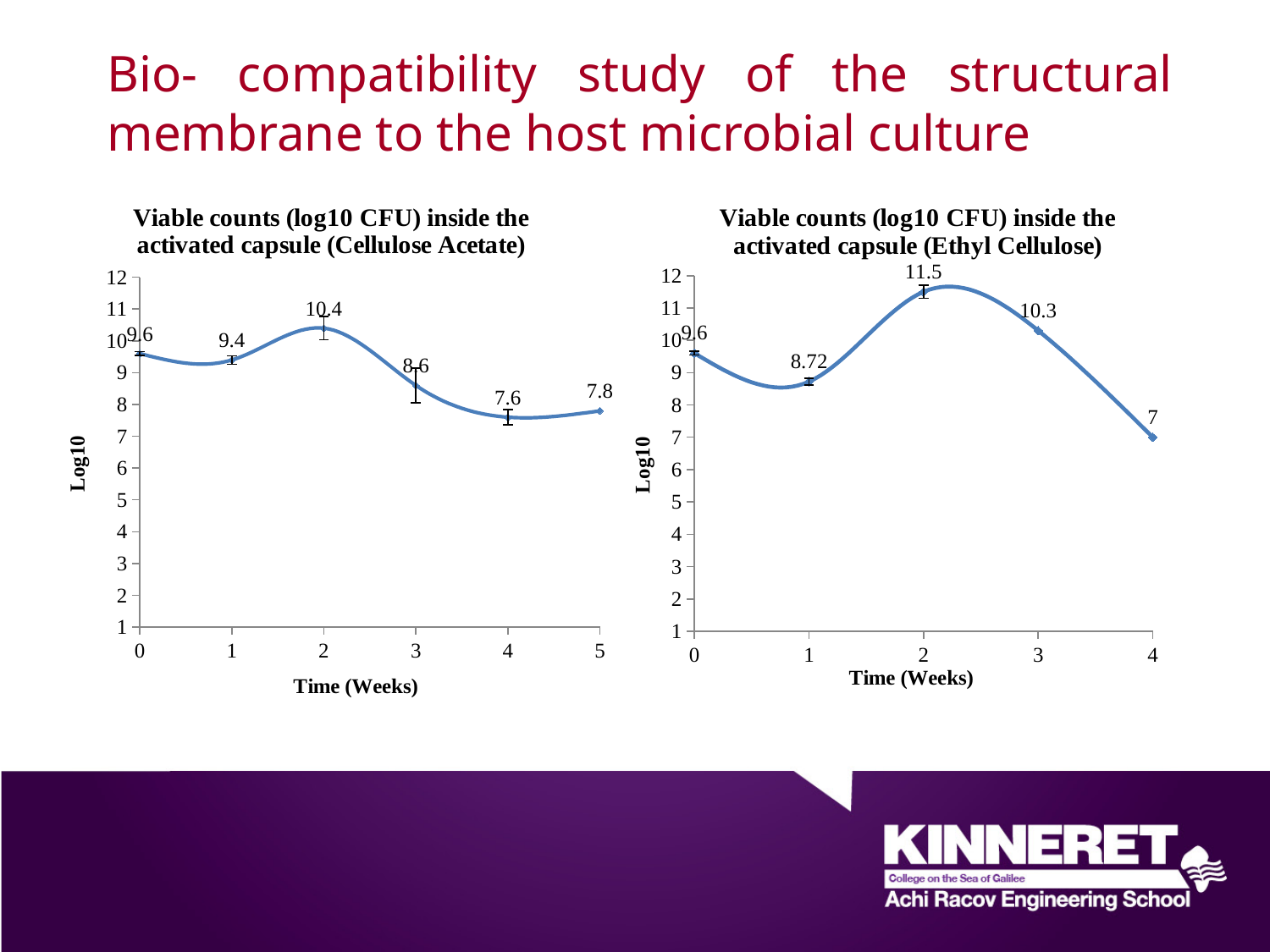
How many data points are plotted in the Cellulose Acetate chart? 6 What is the y-axis label of the Cellulose Acetate chart? Log10 In the Cellulose Acetate chart, what is the viable count at week 2? 10.4 In the Ethyl Cellulose chart, what is the difference between the viable count at week 2 and at week 4? 4.5 In the Cellulose Acetate chart, at which week is the viable count highest? Week 2 In the Ethyl Cellulose chart, what is the viable count at week 4? 7 In the Cellulose Acetate chart, at which week is the viable count lowest? Week 4 In the Cellulose Acetate chart, what is the difference between the viable count at week 0 and at week 5? 1.8 In the Ethyl Cellulose chart, what is the viable count at week 1? 8.72 In the Cellulose Acetate chart, which is larger: the viable count at week 1 or at week 3? Week 1 In the Ethyl Cellulose chart, at which week is the viable count highest? Week 2 What type of chart is the Ethyl Cellulose chart? Line chart